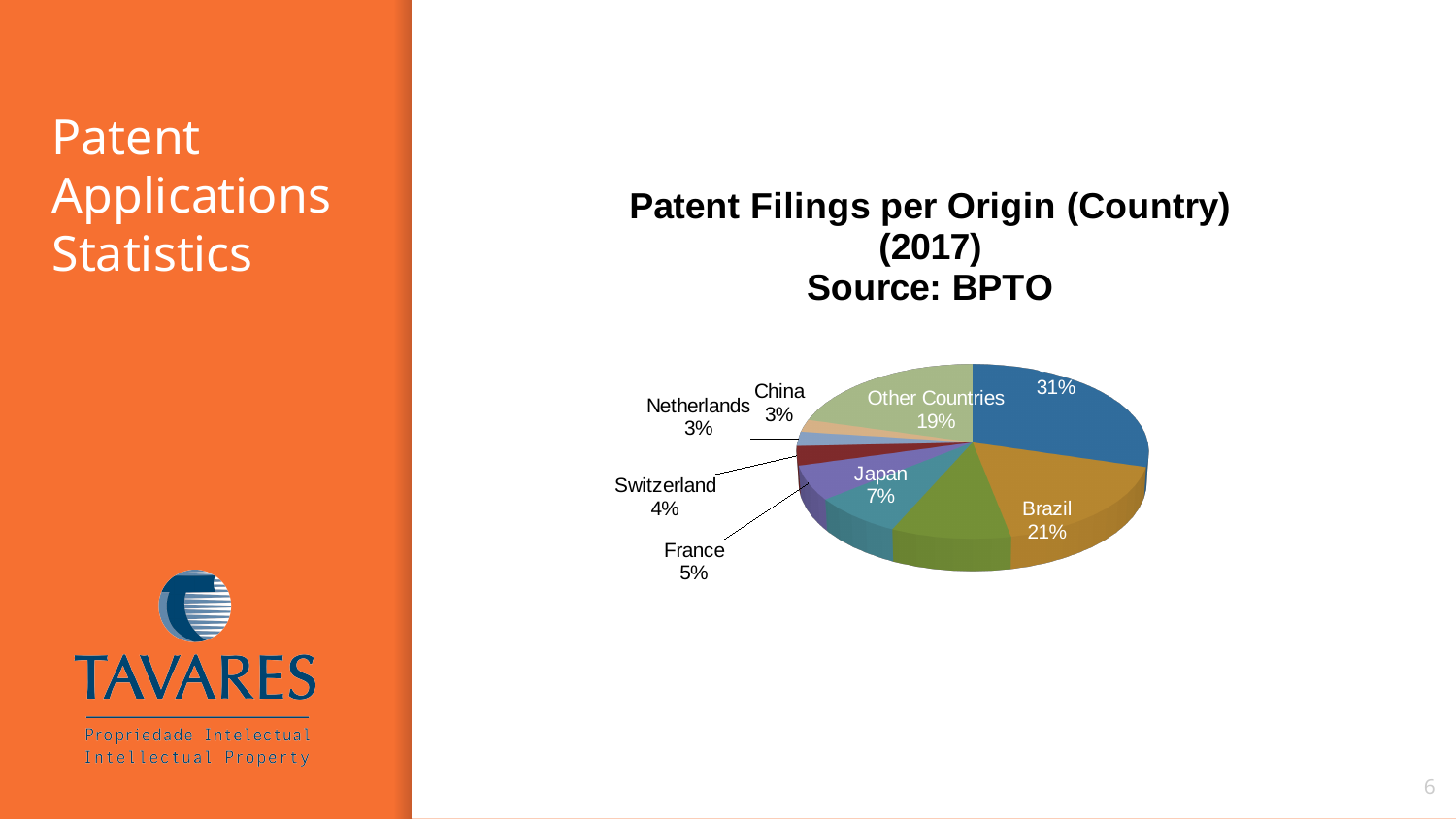
How many percentage points larger is Brazil's share than Japan's? 14 percentage points What share is shown for Other Countries? 19% What share is shown for the Netherlands? 3% What share of patent filings does Brazil account for in the pie chart? 21% Which has the larger share, Brazil or Japan? Brazil According to the chart title, what is the source of the patent filing data? BPTO What kind of chart is used to show patent filings per origin? Pie chart What share is shown for France? 5% What percentage is shown for Japan? 7% Which has the larger share, France or Switzerland? France What percentage of patent filings is attributed to Switzerland? 4% What percentage is shown for China? 3%